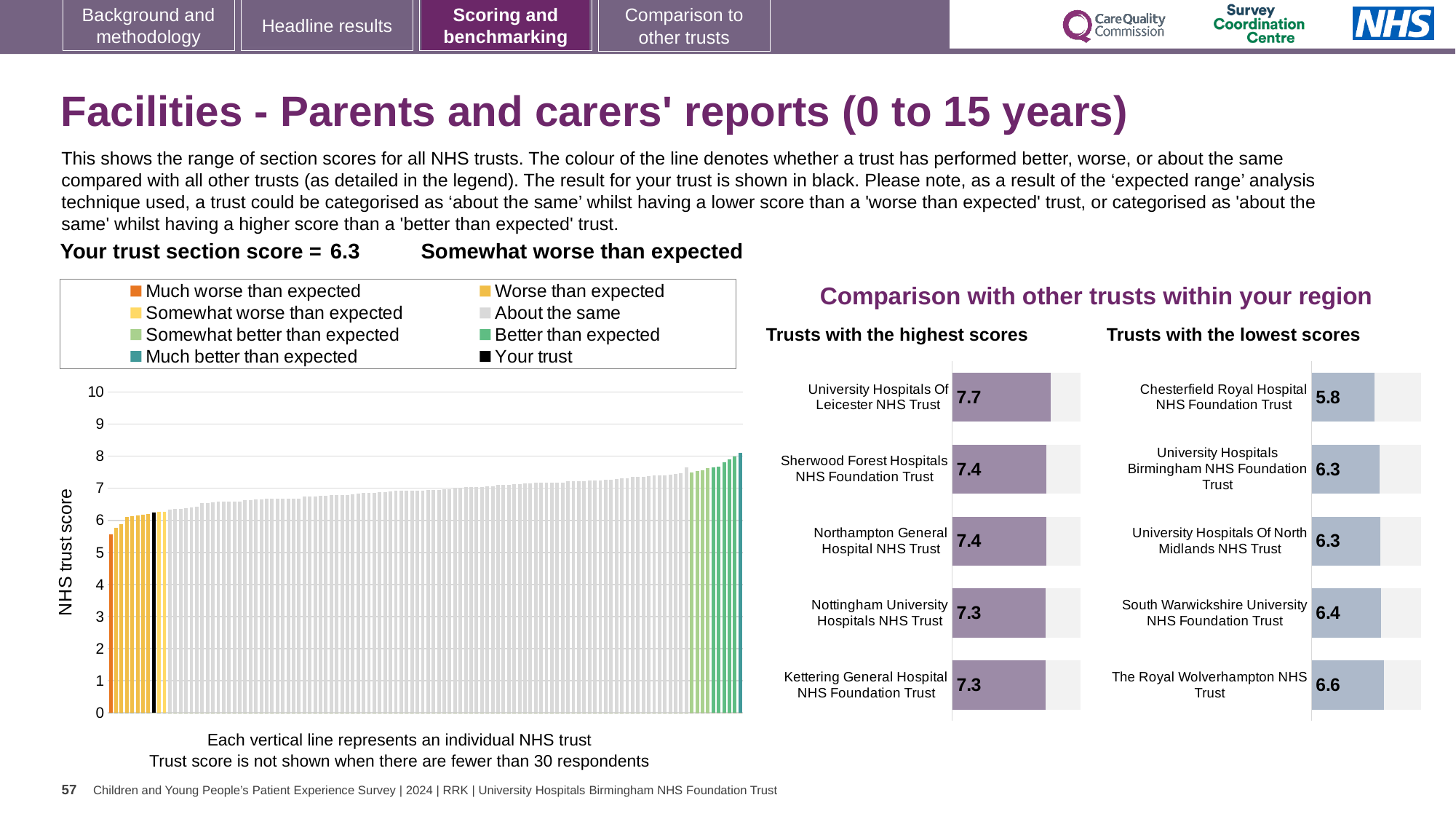
In the 'Trusts with the highest scores' chart, which trust has the highest score? University Hospitals Of Leicester NHS Trust How many trusts are listed in the 'Trusts with the highest scores' chart? 5 In the 'Trusts with the lowest scores' chart, what is the score for The Royal Wolverhampton NHS Trust? 6.6 In the 'Trusts with the lowest scores' chart, what is the difference between the scores of The Royal Wolverhampton NHS Trust and Chesterfield Royal Hospital NHS Foundation Trust? 0.8 In the 'Trusts with the lowest scores' chart, which trust has the lowest score? Chesterfield Royal Hospital NHS Foundation Trust In the 'Trusts with the highest scores' chart, what is the score for Kettering General Hospital NHS Foundation Trust? 7.3 What type of chart is the 'NHS trust score' chart on the left? Bar chart In the 'Trusts with the highest scores' chart, what is the score for University Hospitals Of Leicester NHS Trust? 7.7 In the 'NHS trust score' chart on the left, is the value of the black bar (your trust) greater or less than 7? less In the 'Trusts with the lowest scores' chart, which has the larger score: South Warwickshire University NHS Foundation Trust or University Hospitals Of North Midlands NHS Trust? South Warwickshire University NHS Foundation Trust In the 'Trusts with the highest scores' chart, what is the difference between the scores of University Hospitals Of Leicester NHS Trust and Sherwood Forest Hospitals NHS Foundation Trust? 0.3 In the 'Trusts with the lowest scores' chart, what is the score for Chesterfield Royal Hospital NHS Foundation Trust? 5.8